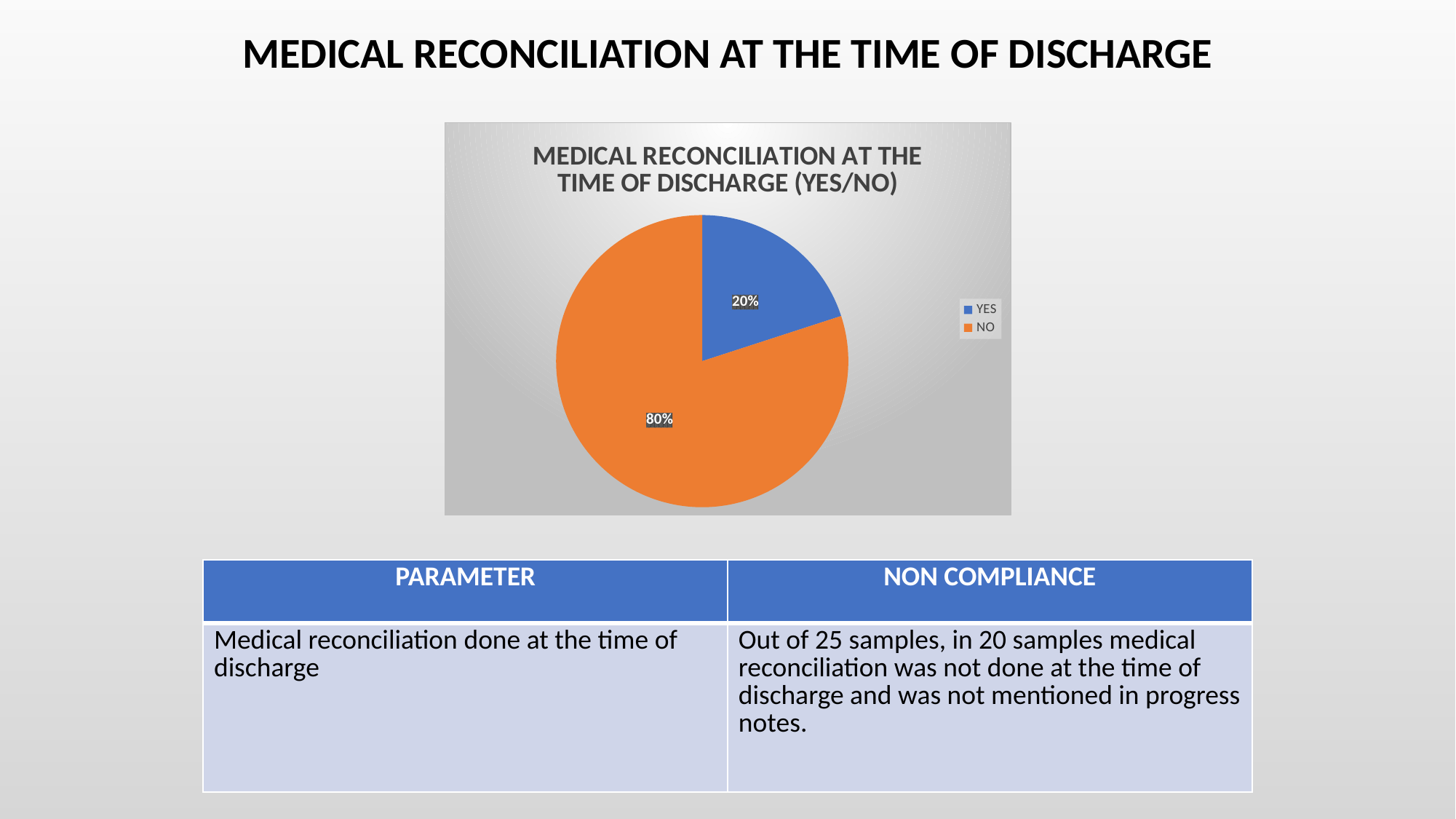
What share of the pie does the NO slice represent? 80% Which is larger, the YES slice or the NO slice? NO What share of the pie does the YES slice represent? 20% What is the title of the pie chart? MEDICAL RECONCILIATION AT THE TIME OF DISCHARGE (YES/NO) What colour is the NO slice in the pie chart? orange How many slices does the pie chart have? 2 What kind of chart is shown on the slide? pie chart What is the difference in percentage points between the NO slice and the YES slice? 60 percentage points Which slice of the pie is the smallest? YES How many entries does the legend list? 2 Which slice of the pie is the largest? NO